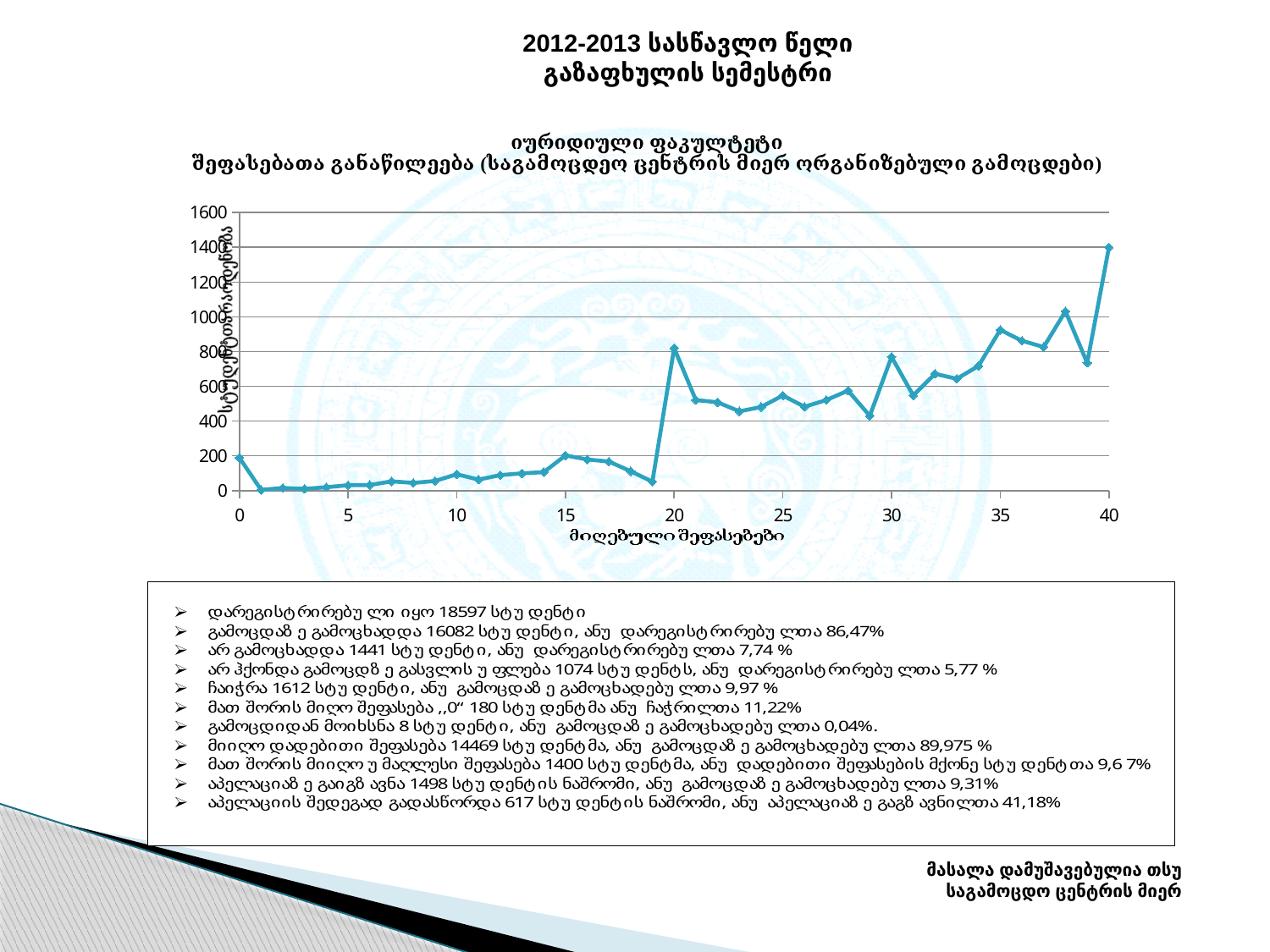
Is the value at x = 15 greater or less than 400? less Is the value at x = 40 greater or less than 1200? greater Which is larger, the value at x = 10 or the value at x = 30? x = 30 Which is larger, the value at x = 19 or the value at x = 20? x = 20 What kind of chart is shown on the slide? line chart Do the values generally rise or fall along the x axis from 20 to 40? rise Is the value at x = 35 greater or less than 800? greater What is the label of the y axis of the chart? სტუდენტთა რაოდენობა What is the label of the x axis of the chart? მიღებული შეფასებები At which x-axis value (received grade) does the line reach its highest point? 40